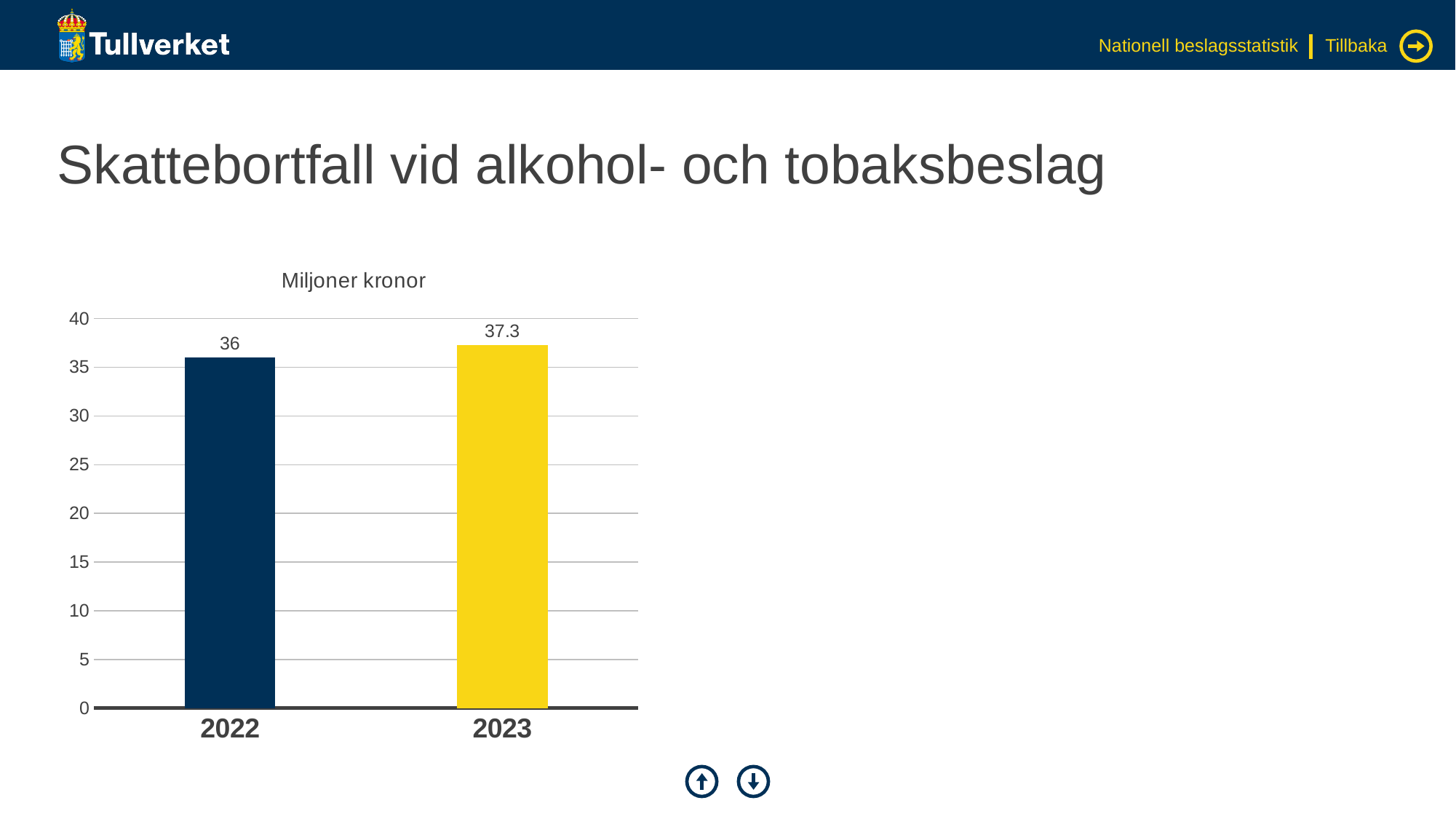
What is the value for 2023? 37.3 What is the value for 2022? 36 Do the values rise or fall from 2022 to 2023? rise What is the difference between the values for 2023 and 2022? 1.3 How many years are shown on the chart? 2 What unit is shown above the chart? Miljoner kronor What kind of chart is shown on the slide? bar chart Which is larger, the value for 2022 or the value for 2023? 2023 Which year has the lowest value? 2022 Is the value for 2023 greater or less than 40? less Which year has the highest value? 2023 Is the value for 2022 greater or less than 35? greater